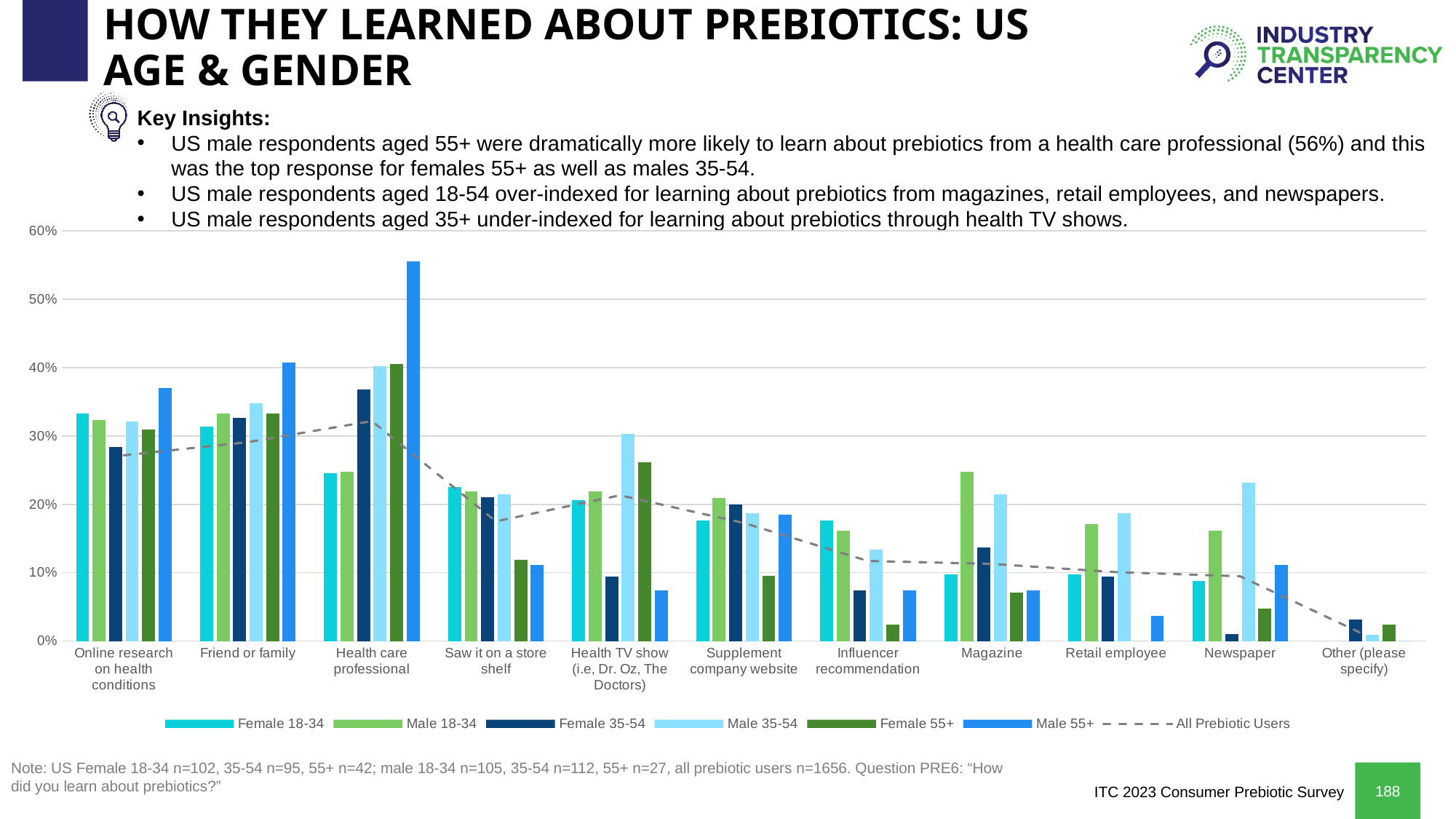
What is the name of the dashed line series in the legend? All Prebiotic Users In the Magazine category, which is larger: the value for Male 18-34 or the value for Female 18-34? Male 18-34 What kind of chart is shown on the slide? Bar chart (with a dashed line series) According to the slide, what percentage of US male respondents aged 55+ learned about prebiotics from a health care professional? 56% Is the value for Male 35-54 in the Health TV show category greater or less than 20%? greater Which category contains the tallest bar in the chart? Health care professional How many categories (ways of learning about prebiotics) are shown on the x axis? 11 Is the value for Female 35-54 in the Newspaper category greater or less than 10%? less Is the value for Male 55+ in the Health care professional category greater or less than 50%? greater In the Friend or family category, which is larger: the value for Male 55+ or the value for Female 18-34? Male 55+ How many series does the legend list? 7